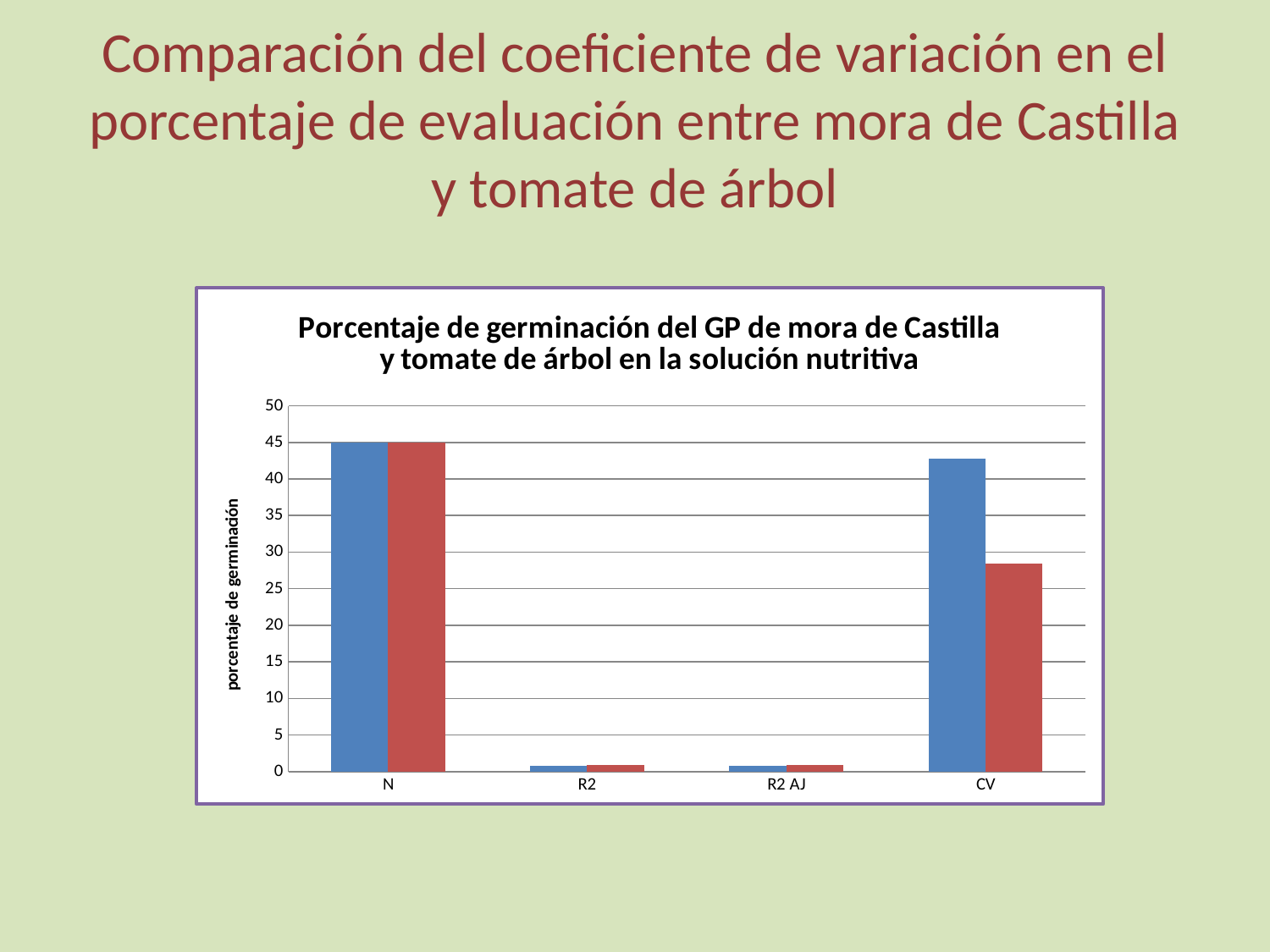
What is the label on the y axis of the chart? porcentaje de germinación Is the red bar for R2 AJ greater or less than 5? less What kind of chart is shown on the slide? bar chart What is the title of the chart? Porcentaje de germinación del GP de mora de Castilla y tomate de árbol en la solución nutritiva Is the blue bar for R2 greater or less than 5? less Is the blue bar for N greater or less than 40? greater Which is larger, the blue bar for N or the blue bar for CV? the blue bar for N Which category has the tallest bars in the chart? N For the CV category, which bar is taller, the blue one or the red one? the blue one How many categories are shown on the x axis of the chart? 4